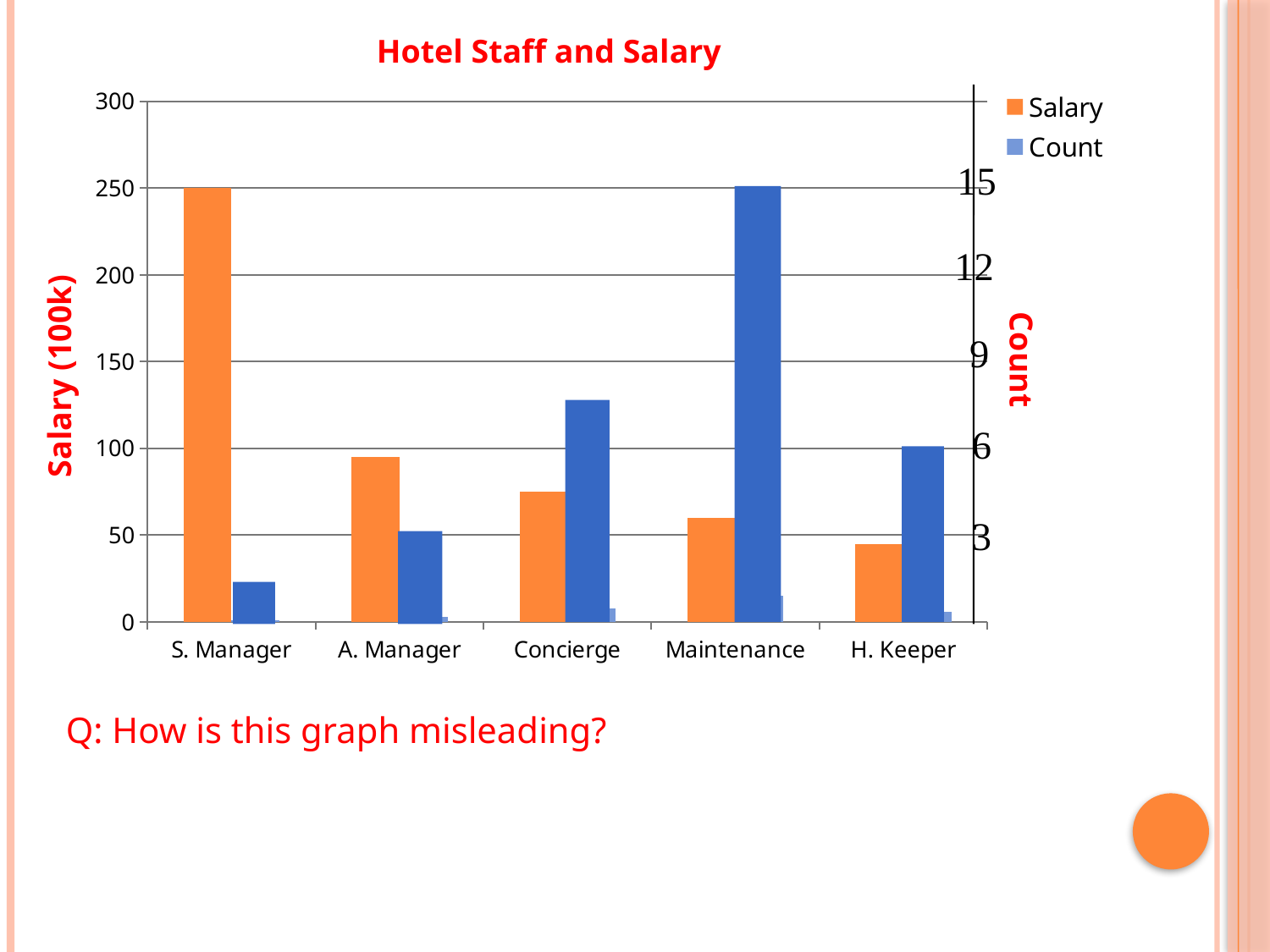
What is the Count value for Maintenance? 15 Is the Salary value for A. Manager greater or less than 100? less Do the Salary values rise or fall moving from S. Manager to H. Keeper along the x axis? fall Which staff category has the highest Count? Maintenance How many staff categories are shown on the x axis? 5 Which staff category has the highest Salary? S. Manager What is the Salary value for S. Manager? 250 Which staff category has the lowest Count? S. Manager Which staff category has the lowest Salary? H. Keeper How many series does the legend list? 2 What kind of chart is shown on the slide? bar chart Which has the larger Count, Concierge or A. Manager? Concierge